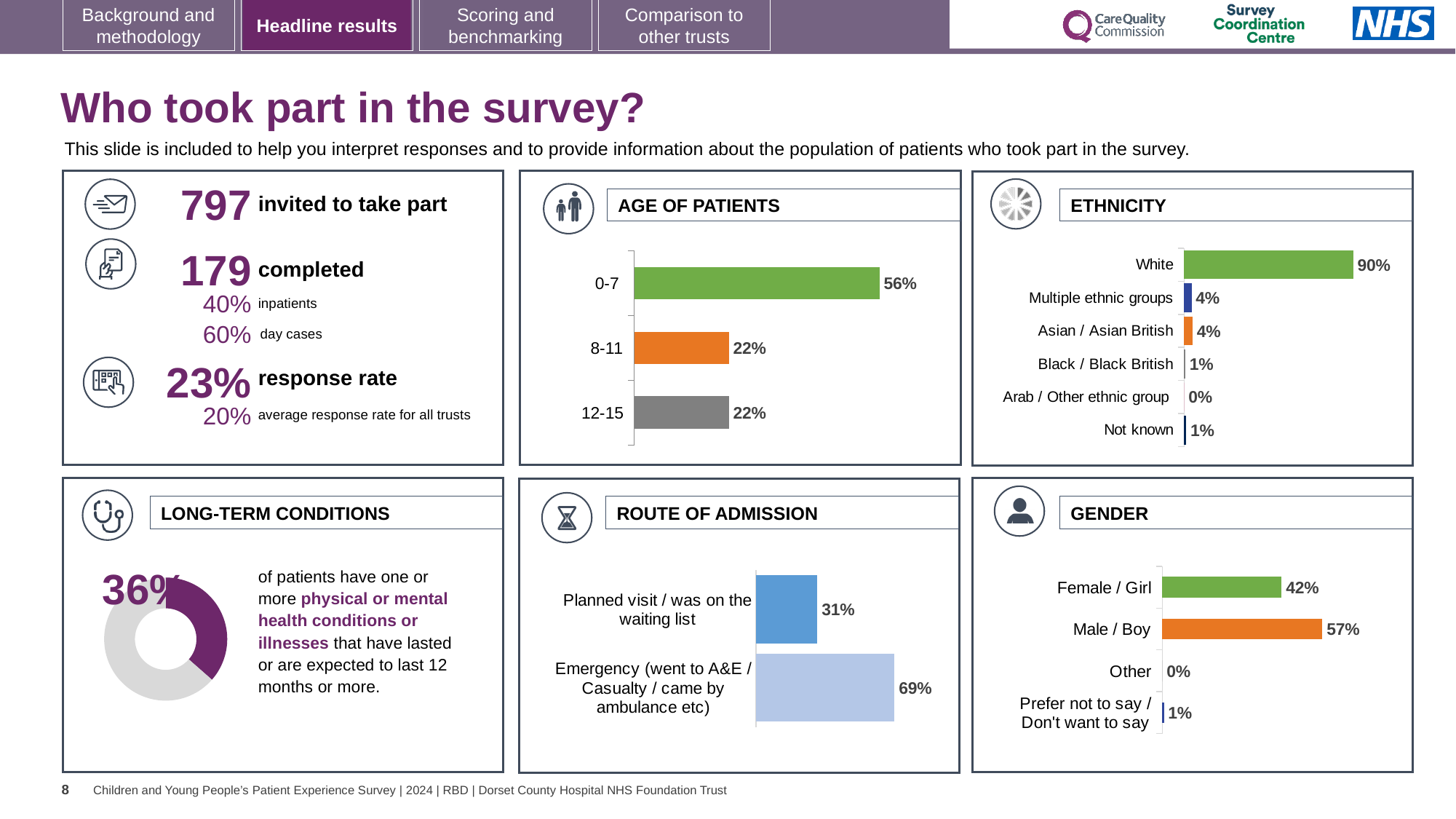
What kind of chart is used in the Gender panel? Bar chart In the Ethnicity chart, what is the difference between the White and Asian / Asian British percentages? 86% In the Long-Term Conditions chart, what percentage of patients have one or more physical or mental health conditions? 36% In the Route of Admission chart, which route has the lower percentage? Planned visit / was on the waiting list In the Age of Patients chart, which age group has the highest percentage? 0-7 In the Age of Patients chart, how many age groups are shown? 3 In the Route of Admission chart, what percentage of patients came via Emergency (went to A&E / Casualty / came by ambulance etc)? 69% In the Ethnicity chart, how many ethnicity categories are listed? 6 In the Age of Patients chart, what percentage of patients were aged 0-7? 56% In the Ethnicity chart, what percentage of patients were White? 90% In the Gender chart, what is the difference between the Male / Boy and Female / Girl percentages? 15% In the Gender chart, what percentage of patients were Male / Boy? 57%